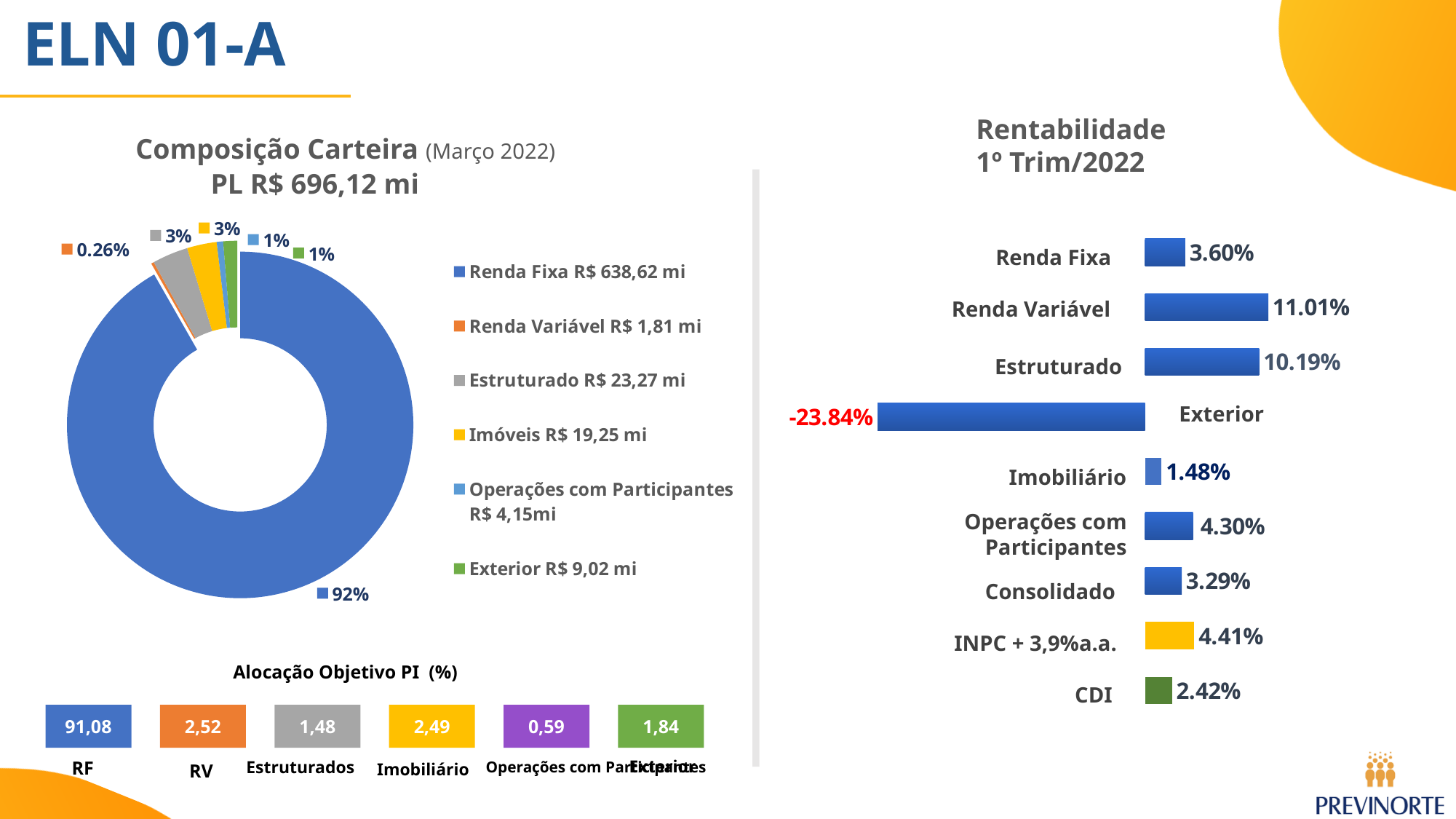
How many categories are shown in the Rentabilidade 1º Trim/2022 chart? 9 In the Composição Carteira donut chart, what share does Renda Variável have? 0.26% In the Composição Carteira chart legend, what amount is shown for Estruturado? R$ 23,27 mi What kind of chart is the Composição Carteira chart? Donut (pie) chart In the Rentabilidade 1º Trim/2022 chart, which is larger: Consolidado or INPC + 3,9%a.a.? INPC + 3,9%a.a. In the Rentabilidade 1º Trim/2022 chart, which category has the lowest value? Exterior In the Rentabilidade 1º Trim/2022 chart, what is the difference between Renda Variável and Estruturado? 0.82% In the Rentabilidade 1º Trim/2022 chart, what is the value for Exterior? -23.84% In the Rentabilidade 1º Trim/2022 chart, which category has the highest value? Renda Variável In the Alocação Objetivo PI (%) chart, what is the value for RF? 91,08 In the Rentabilidade 1º Trim/2022 chart, what is the value for Renda Variável? 11.01% In the Composição Carteira donut chart, what share does Renda Fixa have? 92%